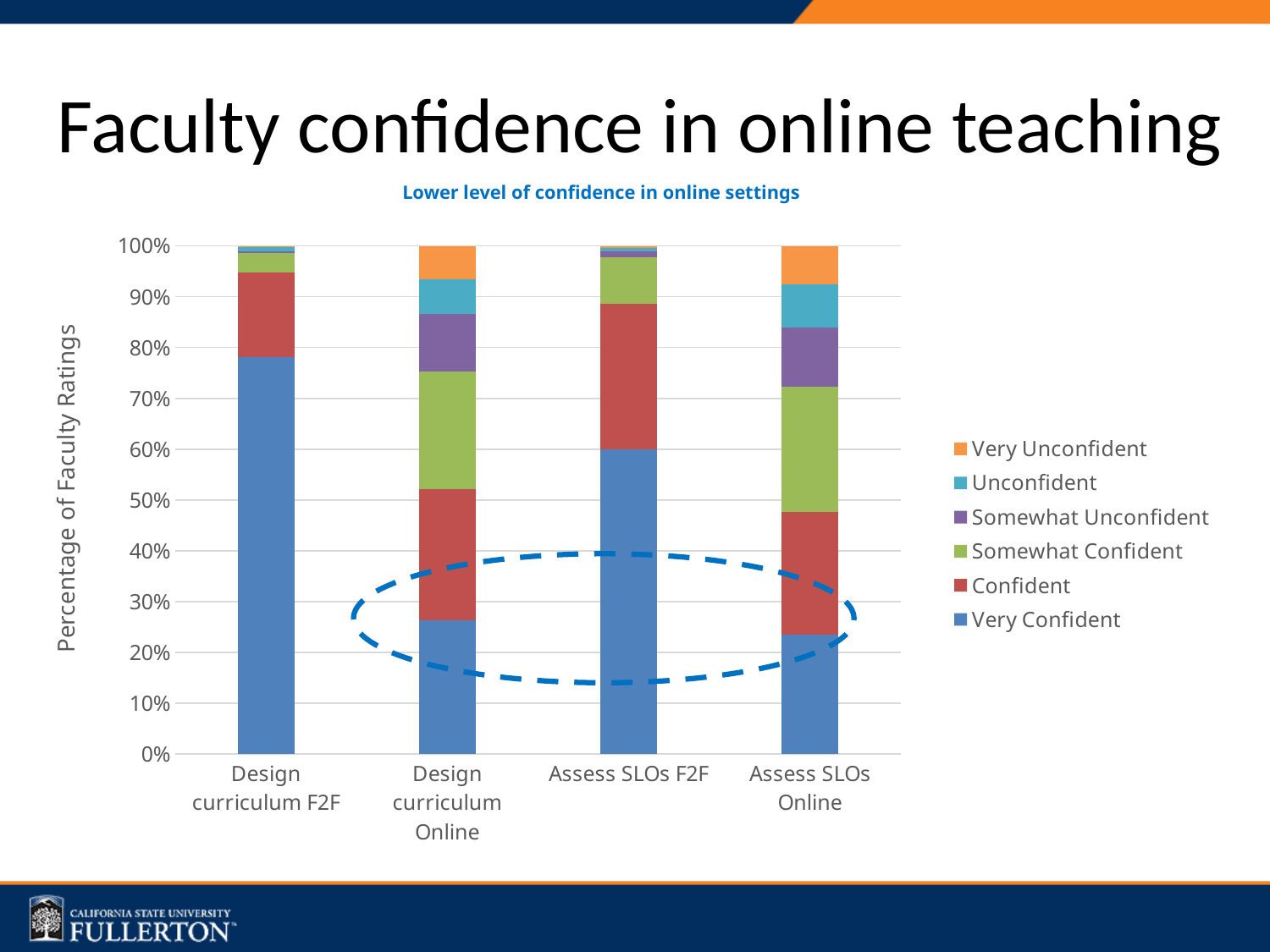
Which category has the largest Very Confident share? Design curriculum F2F What does each stacked bar in the chart total? 100% How many series does the chart legend list? 6 Which has a larger Very Confident share: Assess SLOs F2F or Assess SLOs Online? Assess SLOs F2F Is the Very Confident share for Assess SLOs F2F greater or less than 50%? greater What is the title of the chart? Lower level of confidence in online settings Is the Very Confident share for Design curriculum Online greater or less than 30%? less Is the Very Confident share for Design curriculum F2F greater or less than 70%? greater What kind of chart is shown on the slide? Stacked bar chart How many categories are shown on the x axis of the chart? 4 What is the label of the vertical axis? Percentage of Faculty Ratings Which has a larger Somewhat Confident share: Design curriculum Online or Design curriculum F2F? Design curriculum Online